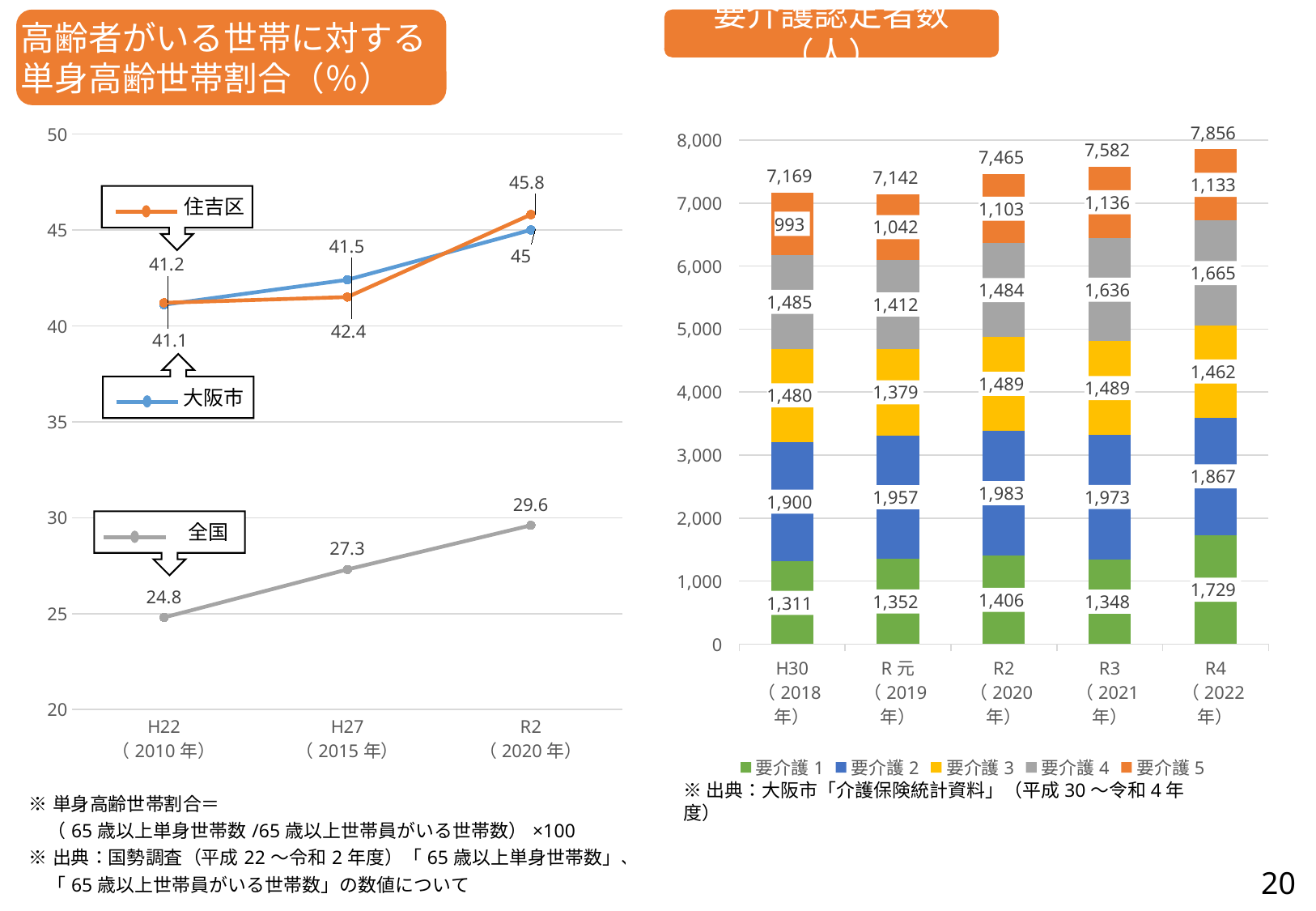
What kind of chart is the right chart? stacked bar chart In the right stacked bar chart, what is the total for R4 (2022年)? 7,856 In the left line chart, what is the value for 住吉区 in R2 (2020年)? 45.8 In the left line chart, does the 全国 series rise or fall from H22 to R2? rise In the right stacked bar chart, what is the difference between the 要介護1 values in R4 (2022年) and R3 (2021年)? 381 In the right stacked bar chart, what is the value for 要介護2 in R2 (2020年)? 1,983 In the right stacked bar chart, how many categories are shown on the x axis? 5 In the left line chart, what is the value for 大阪市 in H22 (2010年)? 41.1 In the right stacked bar chart, which year has the lowest total? R元 (2019年) In the left line chart, what is the value for 全国 in H27 (2015年)? 27.3 In the left line chart, what is the difference between the 全国 values in R2 (2020年) and H22 (2010年)? 4.8 In the left line chart, how many series does the legend list? 3